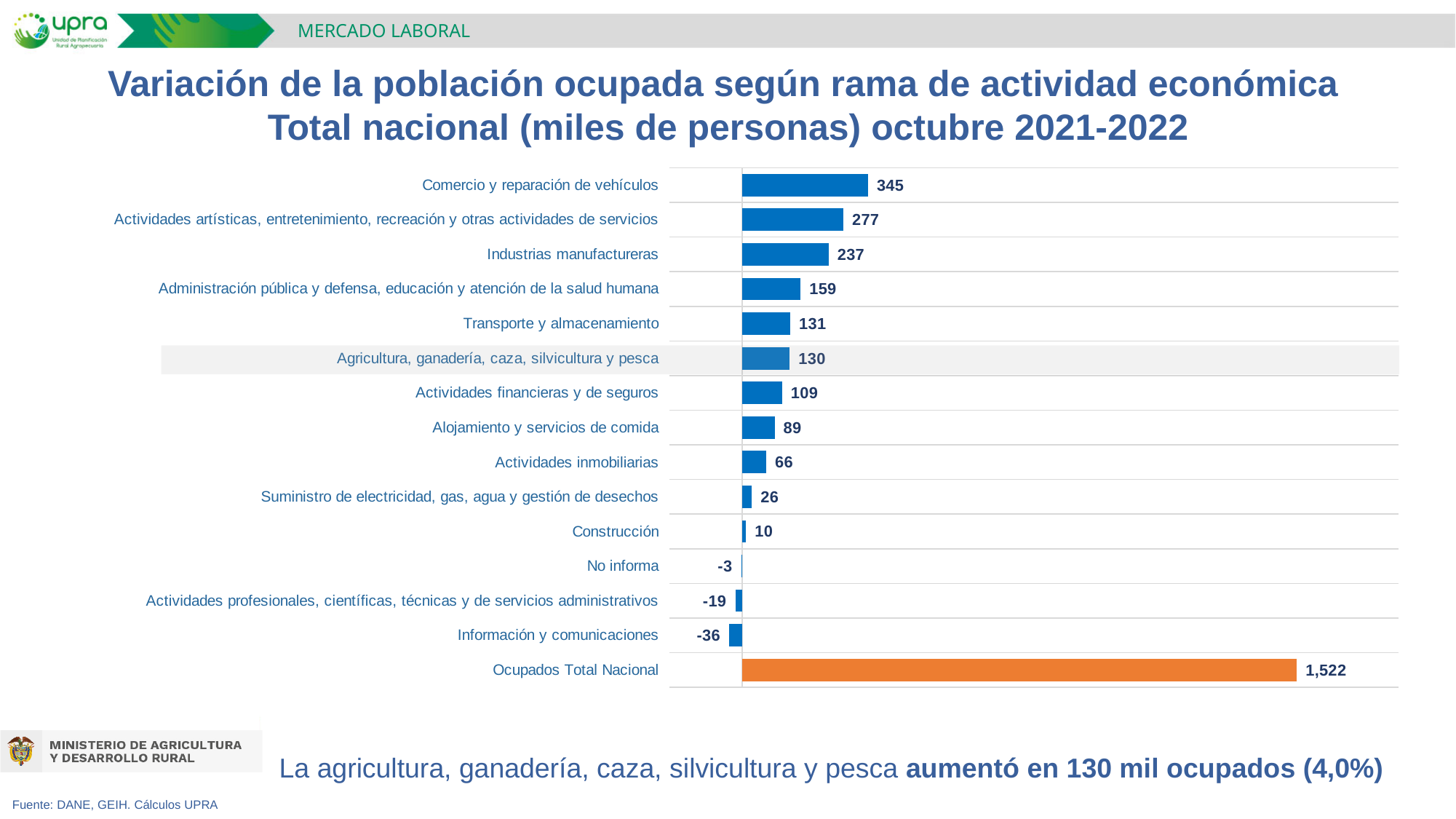
What is the value for Agricultura, ganadería, caza, silvicultura y pesca? 130 What colour is the bar for Ocupados Total Nacional? Orange What is the value for Construcción? 10 Excluding Ocupados Total Nacional, which category has the highest value? Comercio y reparación de vehículos Which is larger, the value for Transporte y almacenamiento or the value for Actividades financieras y de seguros? Transporte y almacenamiento What is the value for Ocupados Total Nacional? 1,522 How many categories are shown in the chart? 15 What is the difference between the values for Comercio y reparación de vehículos and Industrias manufactureras? 108 What is the value for Información y comunicaciones? -36 What is the value for Comercio y reparación de vehículos? 345 What kind of chart is shown on the slide? Bar chart Which category has the lowest value? Información y comunicaciones